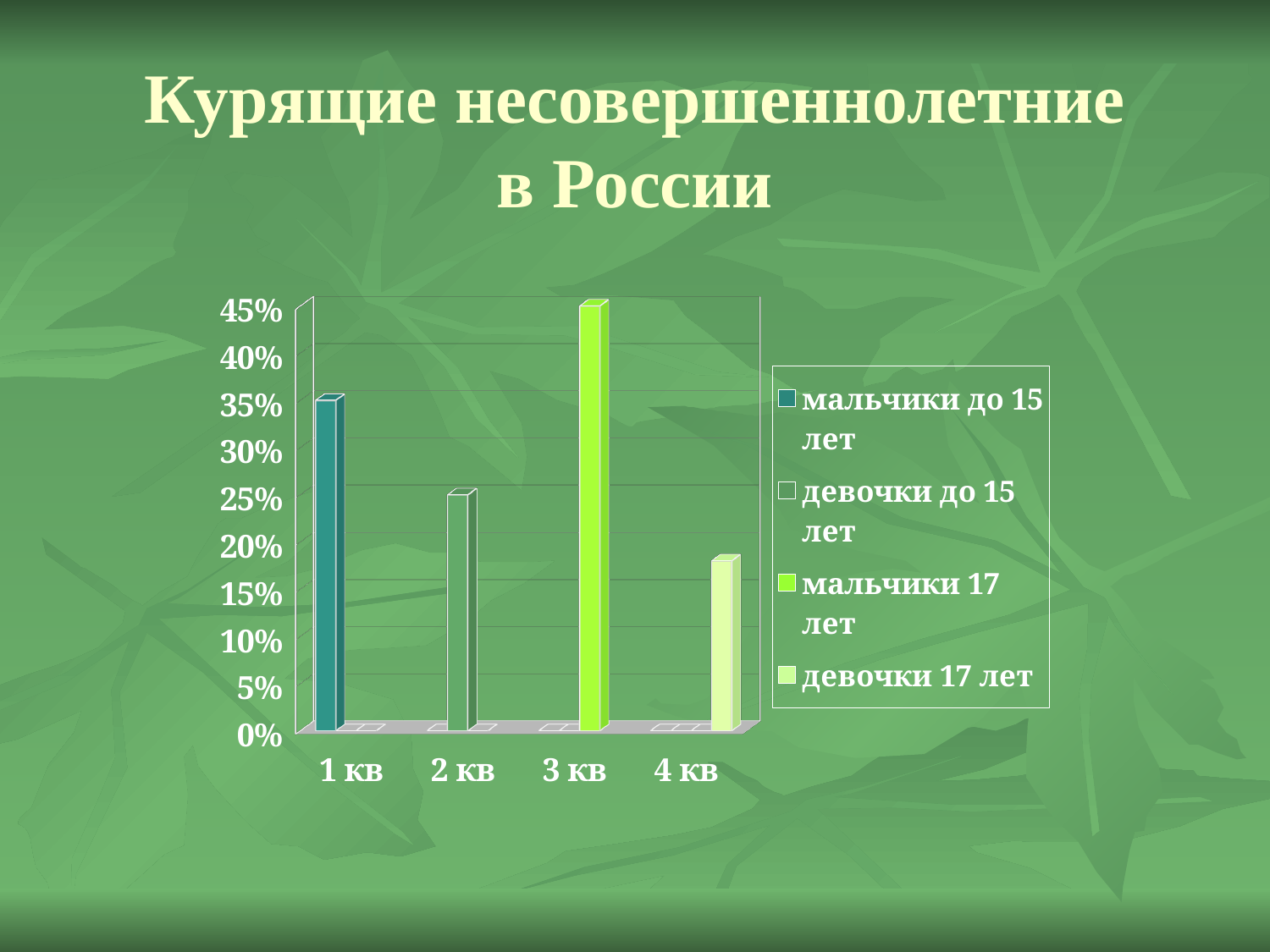
Which category has the lowest bar in the chart? 4 кв How many categories are shown on the x axis of the chart? 4 Which legend entry is shown in bright green in the chart? мальчики 17 лет Is the value for 1 кв greater or less than 30%? greater Is the value for 4 кв greater or less than 20%? less Which bar is taller, 2 кв or 4 кв? 2 кв What kind of chart is shown on the slide? bar chart Which category has the highest bar in the chart? 3 кв How many series does the chart's legend list? 4 Is the value for 3 кв greater or less than 40%? greater What is the title of the slide containing the chart? Курящие несовершеннолетние в России Which bar is taller, 1 кв or 2 кв? 1 кв